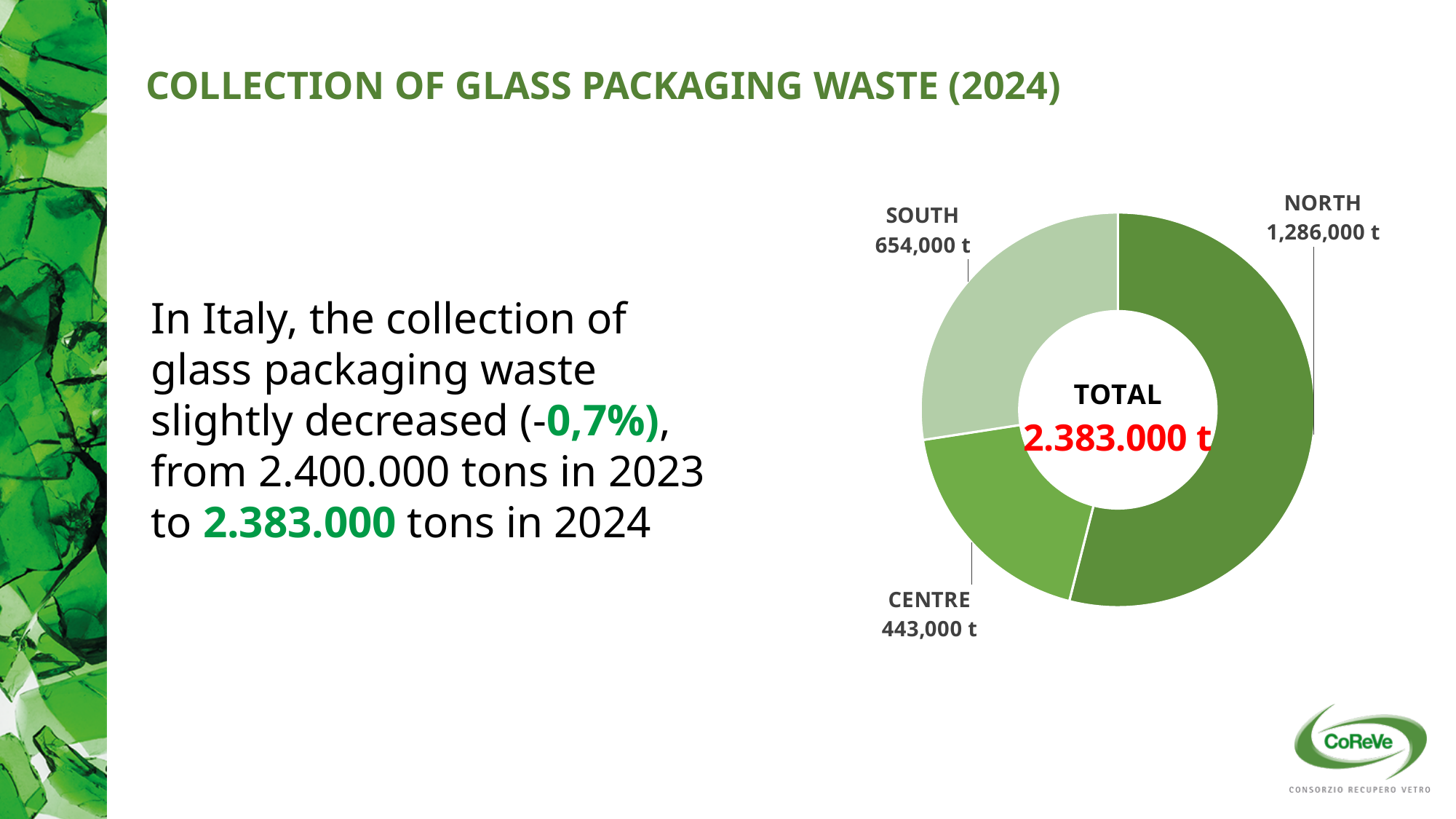
Which is larger in the chart, SOUTH or CENTRE? SOUTH What is the value for CENTRE in the donut chart? 443,000 t Which region has the highest collection of glass packaging waste in the chart? NORTH How many regions are shown in the donut chart? 3 What is the value for NORTH in the donut chart? 1,286,000 t What is the title of the slide containing the chart? COLLECTION OF GLASS PACKAGING WASTE (2024) What total is shown in the centre of the donut chart? 2.383.000 t Which region has the lowest collection of glass packaging waste in the chart? CENTRE What kind of chart is shown on the slide? Donut chart What is the difference between the NORTH and SOUTH values in the chart? 632,000 t What is the difference between the SOUTH and CENTRE values in the chart? 211,000 t What is the value for SOUTH in the donut chart? 654,000 t